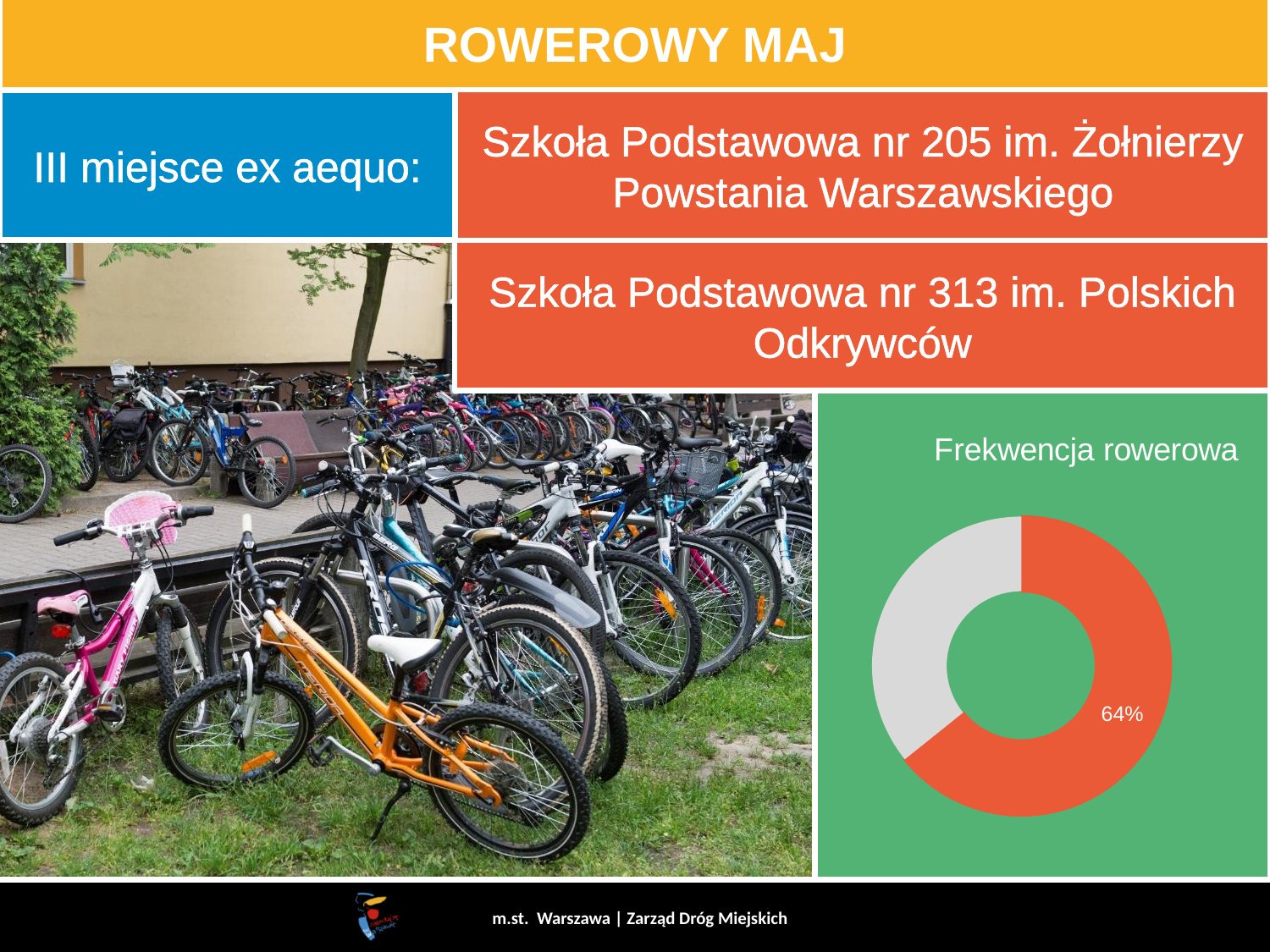
What is the title of the chart on the slide? Frekwencja rowerowa How many slices does the donut chart have? 2 What share of the donut chart does the orange slice represent? 64% Is the value of the labelled slice in the donut chart greater or less than 50%? greater Which slice of the donut chart is larger, the orange one or the grey one? The orange one What value is printed on the labelled slice of the donut chart? 64% What kind of chart is shown on the slide? Donut (pie) chart What colour is the slice labelled 64% in the donut chart? Orange